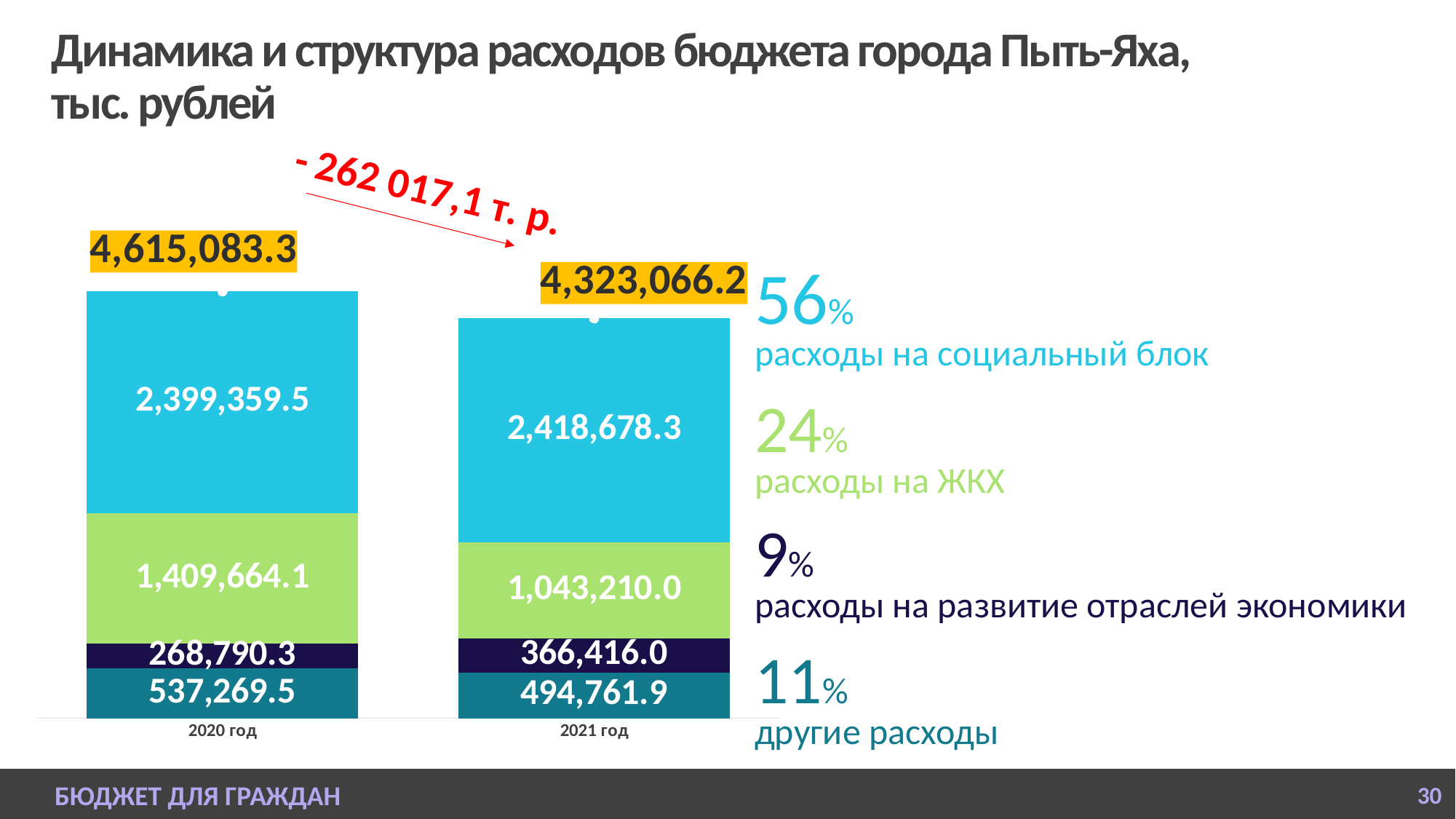
How many years (categories) are shown on the x axis of the chart? 2 What is the value of the teal bottom segment (другие расходы) for 2020 год? 537,269.5 What is the value of the green segment (расходы на ЖКХ) for 2020 год? 1,409,664.1 What percentage share is given on the slide for расходы на социальный блок? 56% Does the total expenditure rise or fall from 2020 год to 2021 год? fall Which year has the larger value for the dark navy segment (расходы на развитие отраслей экономики), 2020 год or 2021 год? 2021 год What is the total budget expenditure shown for 2021 год? 4,323,066.2 By how much did the green segment (расходы на ЖКХ) decrease from 2020 год to 2021 год? 366,454.1 What is the value of the dark navy segment (расходы на развитие отраслей экономики) for 2021 год? 366,416.0 What is the total budget expenditure shown for 2020 год? 4,615,083.3 What type of chart is shown on the slide? stacked bar chart What is the value of the light blue segment (расходы на социальный блок) for 2021 год? 2,418,678.3